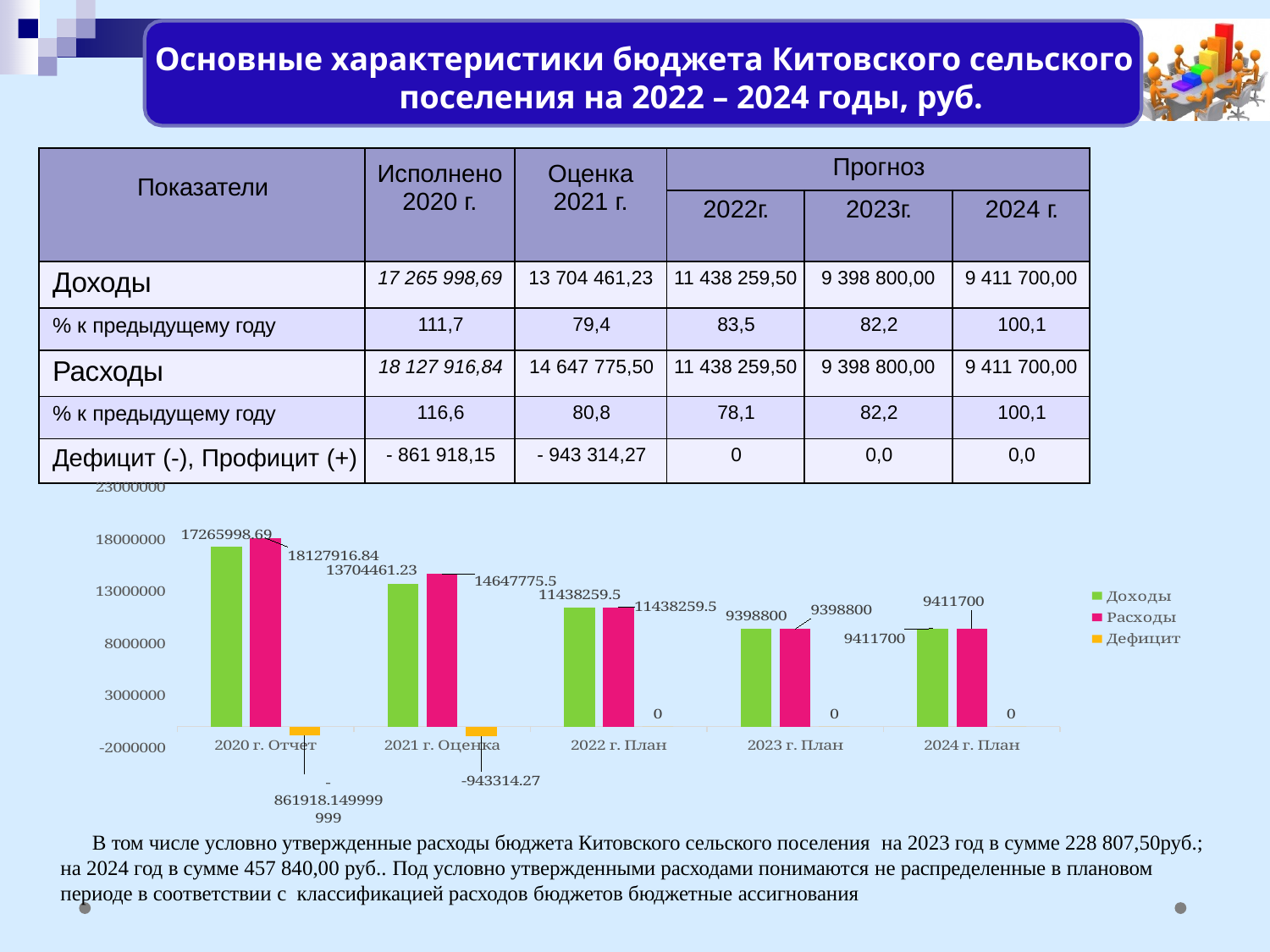
What is the value of Доходы for 2020 г. Отчет in the chart? 17265998.69 What is the value of Расходы for 2024 г. План in the chart? 9411700 What kind of chart is shown on the slide? bar chart How many series does the chart legend list? 3 In the chart, which is larger for 2021 г. Оценка: Доходы or Расходы? Расходы Which category has the lowest Расходы value in the chart? 2023 г. План What is the value of Дефицит for 2021 г. Оценка in the chart? -943314.27 What is the difference between Расходы and Доходы for 2020 г. Отчет in the chart? 861918.15 Do the Доходы values rise or fall from 2020 г. Отчет to 2023 г. План in the chart? fall Which category has the highest Доходы value in the chart? 2020 г. Отчет How many categories are shown along the x axis of the chart? 5 What is the value of Расходы for 2021 г. Оценка in the chart? 14647775.5